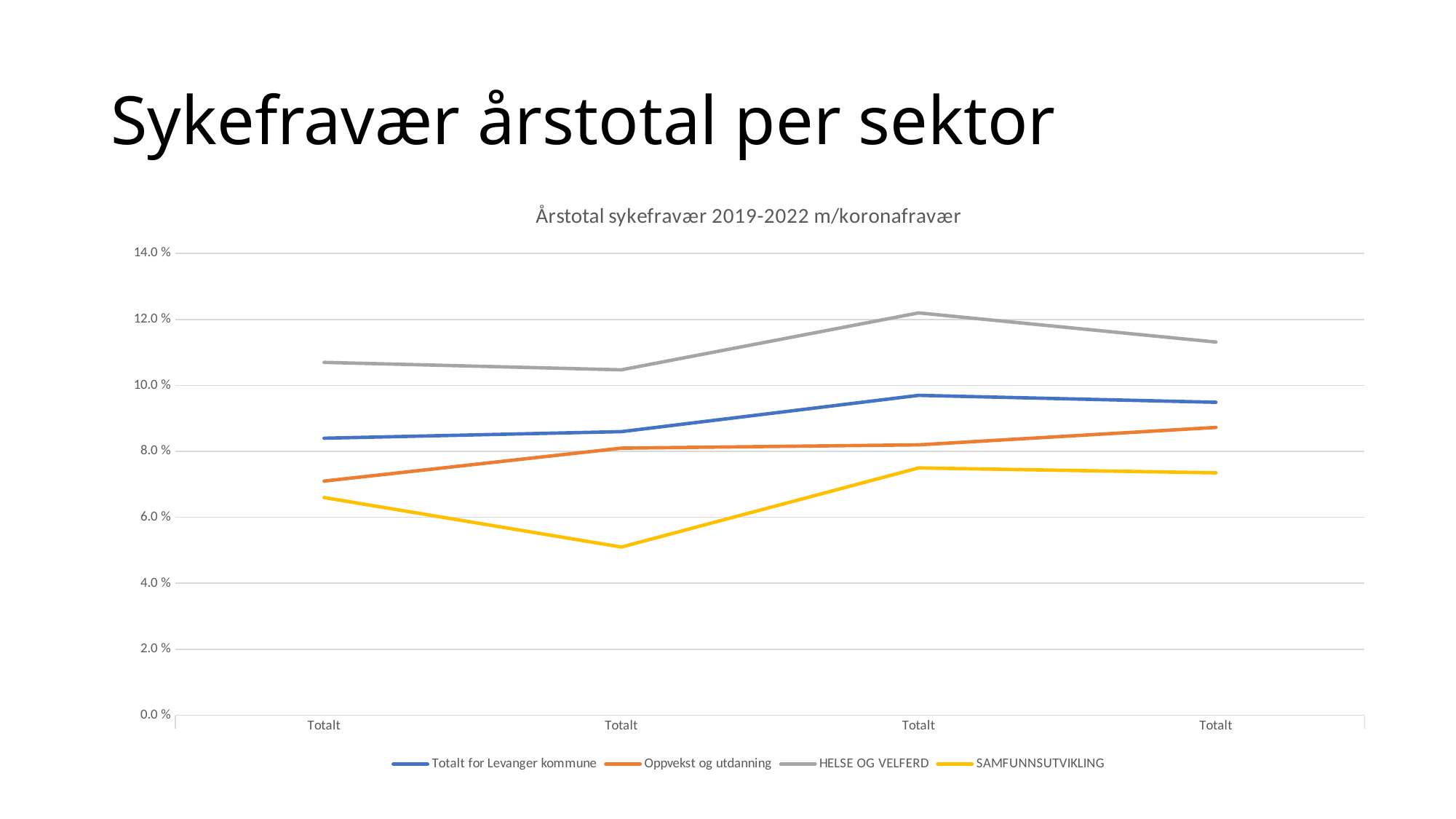
Does the SAMFUNNSUTVIKLING line rise or fall from the second point to the third point? rise Is the value for HELSE OG VELFERD at the first point greater or less than 10.0 %? greater How many series does the legend list? 4 Which series has the highest values across the whole chart? HELSE OG VELFERD Is the value for SAMFUNNSUTVIKLING at the second point greater or less than 6.0 %? less Which series has the lowest values across the whole chart? SAMFUNNSUTVIKLING What colour is the line for SAMFUNNSUTVIKLING? yellow What kind of chart is shown on the slide? line chart At the second point, which is larger: HELSE OG VELFERD or Totalt for Levanger kommune? HELSE OG VELFERD Is the value for Oppvekst og utdanning at the first point greater or less than 8.0 %? less How many points are plotted along the x axis for each series? 4 What is the title of the chart? Årstotal sykefravær 2019-2022 m/koronafravær